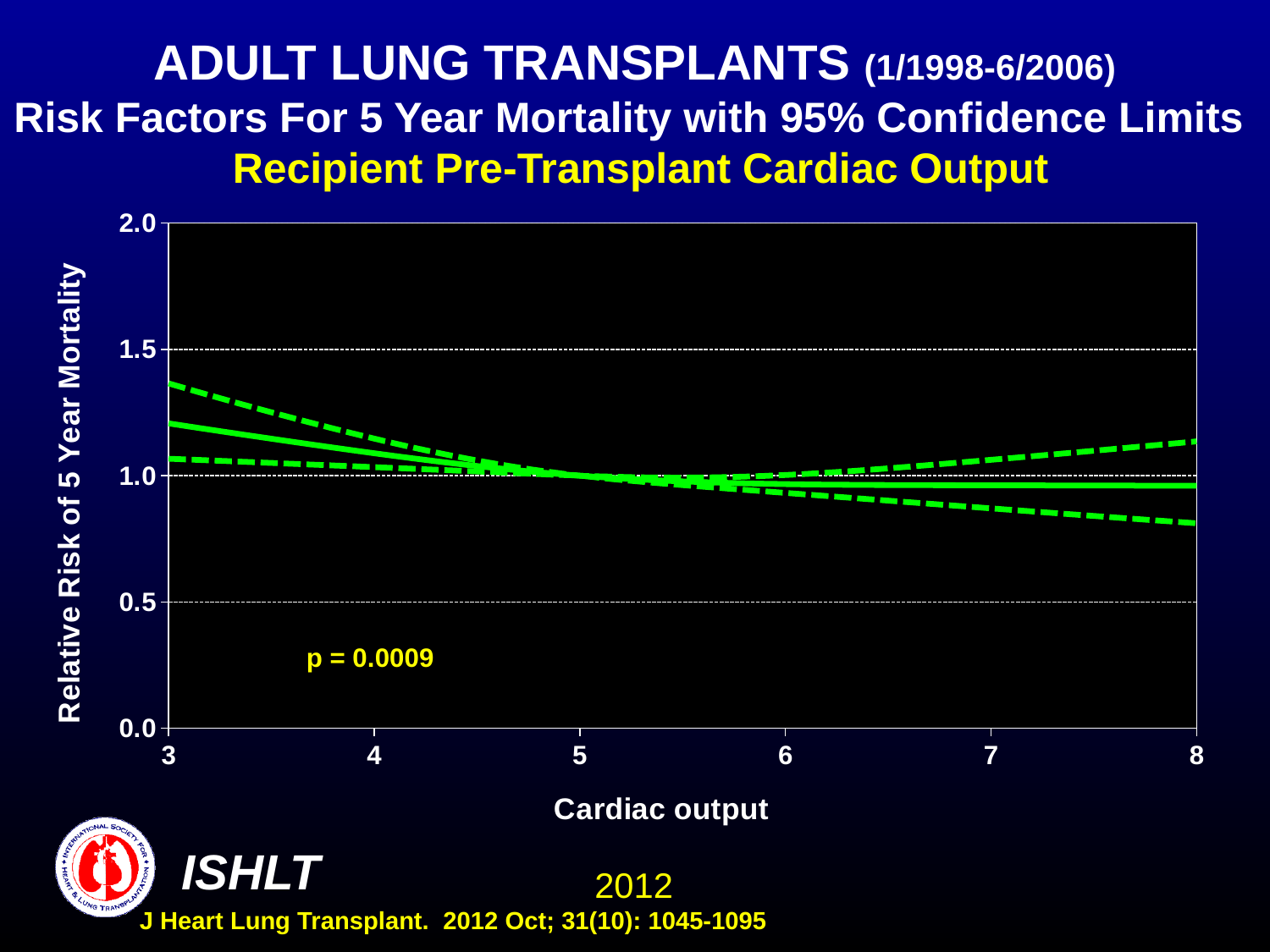
What is the maximum value shown on the y axis? 2.0 What is the label of the y axis? Relative Risk of 5 Year Mortality Is the upper confidence limit (upper dashed line) at a cardiac output of 3 greater or less than 1.5? less Is the lower confidence limit (lower dashed line) at a cardiac output of 8 greater or less than 1.0? less How many lines are plotted on the chart? 3 What is the title of the chart (the yellow subtitle)? Recipient Pre-Transplant Cardiac Output What p-value is printed on the chart? p = 0.0009 Is the relative risk (solid line) at a cardiac output of 3 greater or less than 1.0? greater Does the solid relative risk line rise or fall as cardiac output increases from 3 to 8? fall What kind of chart is shown on the slide? line chart